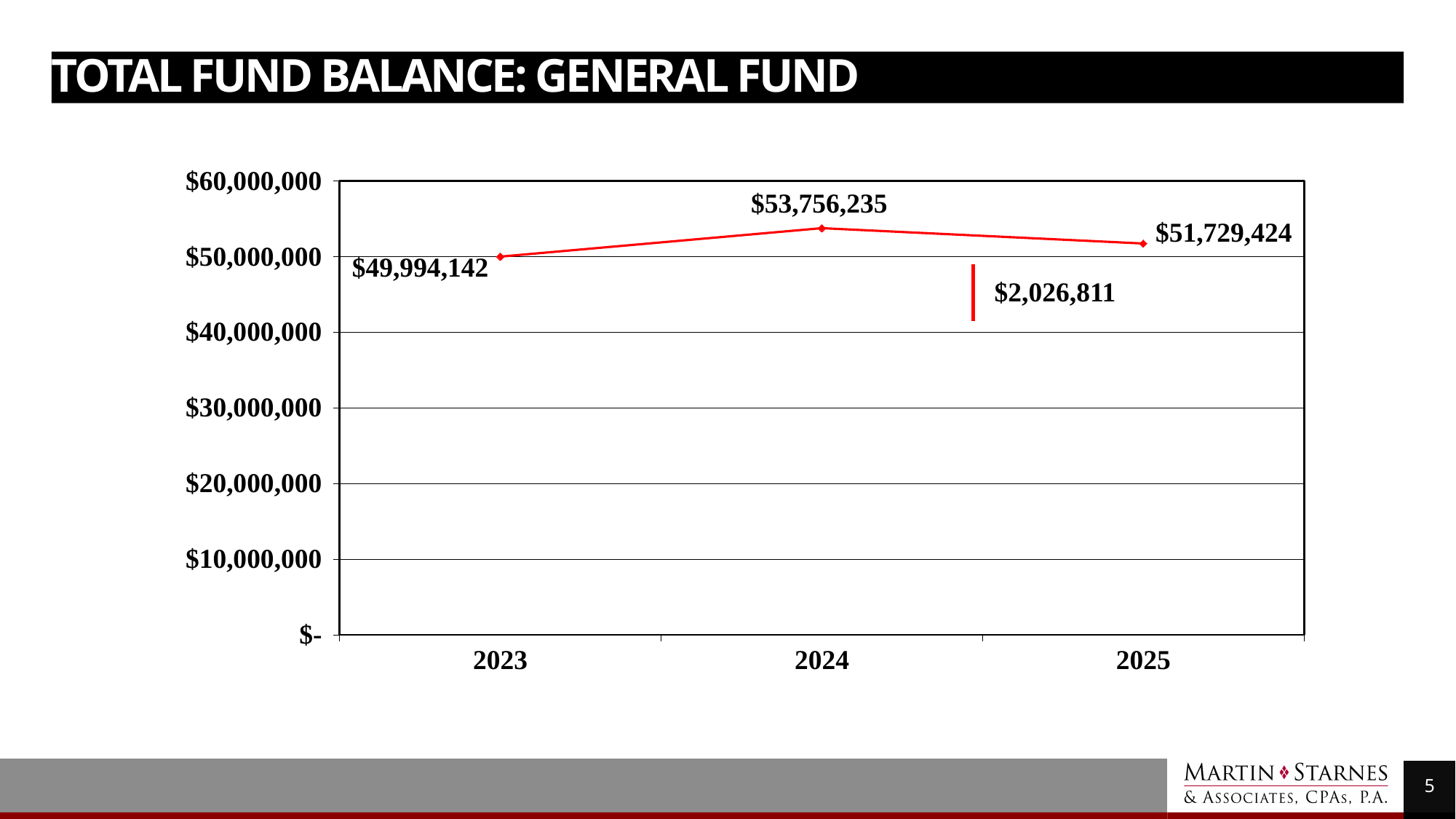
Is the fund balance for 2023 greater or less than $50,000,000? less Which year has the highest total fund balance? 2024 What is the title of the chart? Total Fund Balance: General Fund What is the total fund balance for 2023? $49,994,142 How many years are plotted on the chart? 3 What is the difference between the 2024 and 2023 fund balances? $3,762,093 Which year has a larger fund balance, 2023 or 2025? 2025 What is the total fund balance for 2024? $53,756,235 What kind of chart is shown on the slide? line chart What is the total fund balance for 2025? $51,729,424 Which year has the lowest total fund balance? 2023 What is the difference between the 2024 and 2025 fund balances? $2,026,811